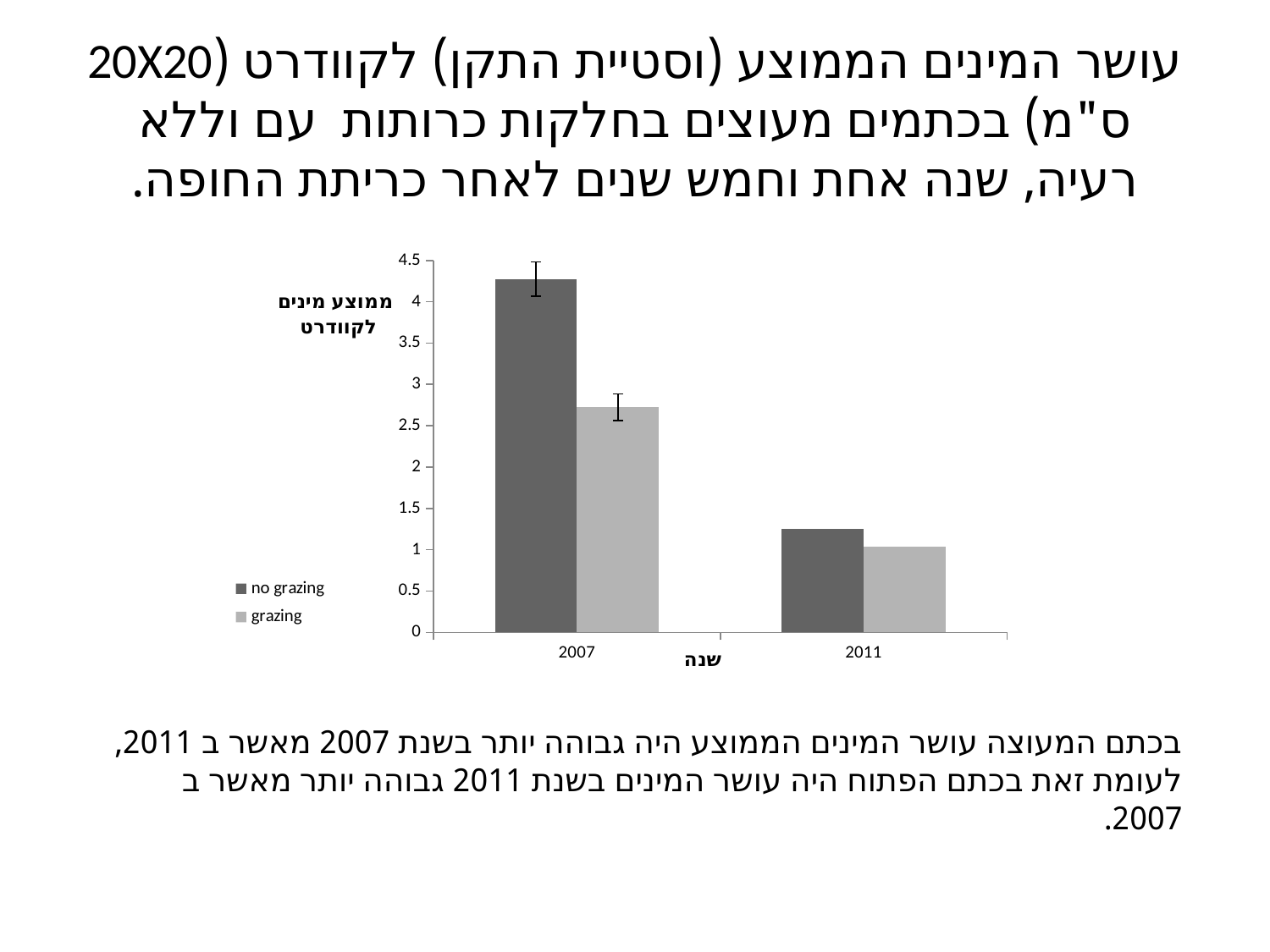
Is the value for no grazing in 2011 greater or less than 1.5? less What are the two entries listed in the legend? no grazing, grazing Which series and year has the highest bar? no grazing, 2007 What kind of chart is shown on the slide? bar chart How many year categories are shown on the x axis? 2 In 2007, which is larger: no grazing or grazing? no grazing Is the value for grazing in 2007 greater or less than 2.5? greater Which series and year has the lowest bar? grazing, 2011 Is the value for no grazing in 2007 greater or less than 4? greater Do the values for the no grazing series rise or fall from 2007 to 2011? fall How many series does the legend list? 2